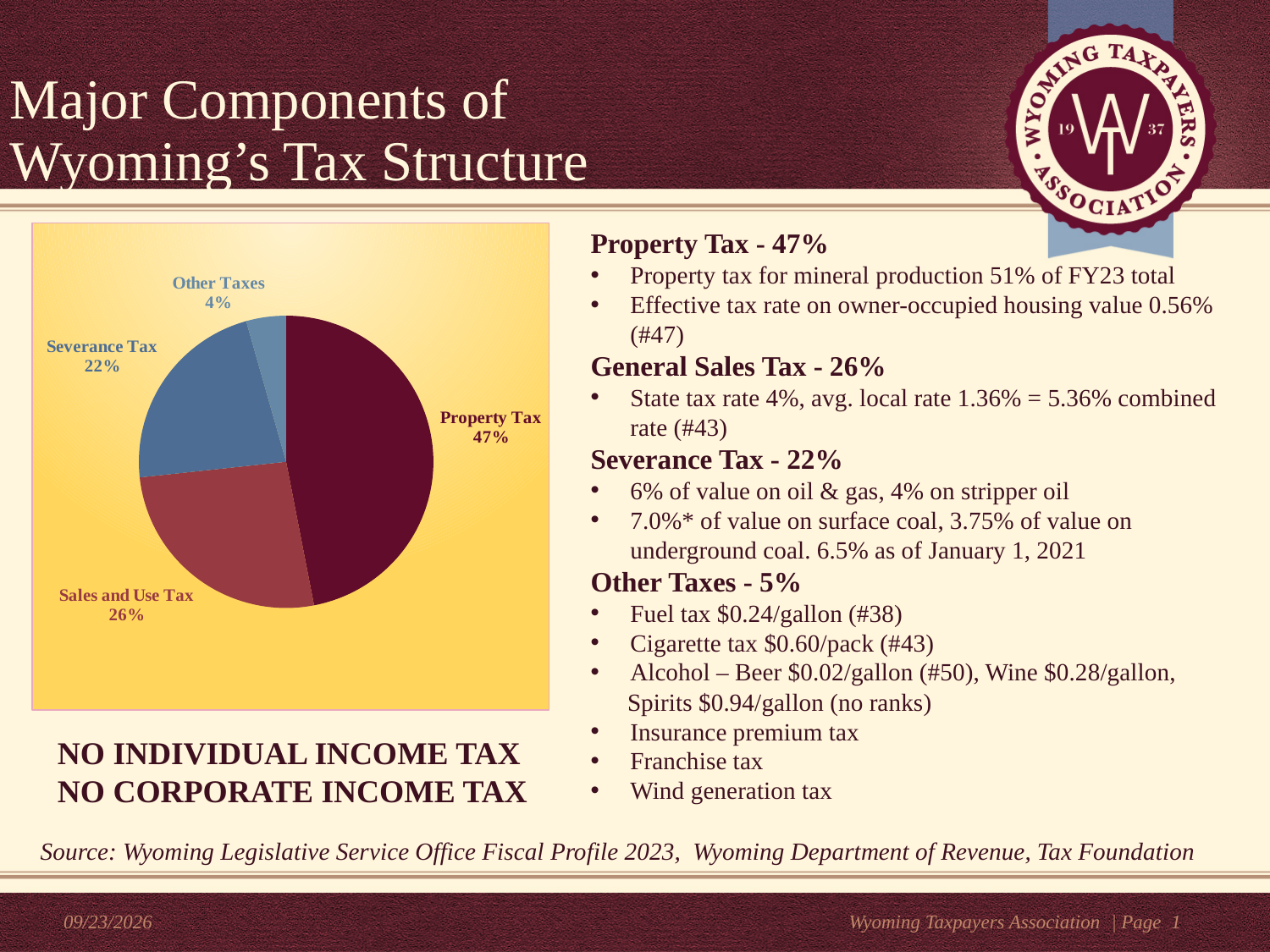
Which slice of the pie chart is the smallest? Other Taxes What share of the pie does Other Taxes represent? 4% What is the difference in percentage points between Property Tax and Sales and Use Tax in the pie chart? 21 What kind of chart is shown on the slide? pie chart How many slices does the pie chart have? 4 What is the difference in percentage points between Severance Tax and Other Taxes in the pie chart? 18 Which slice of the pie chart is the largest? Property Tax What colour is the Property Tax slice in the pie chart? dark maroon Which is larger in the pie chart, Sales and Use Tax or Severance Tax? Sales and Use Tax What share of the pie does Property Tax represent? 47% What share of the pie does Sales and Use Tax represent? 26%